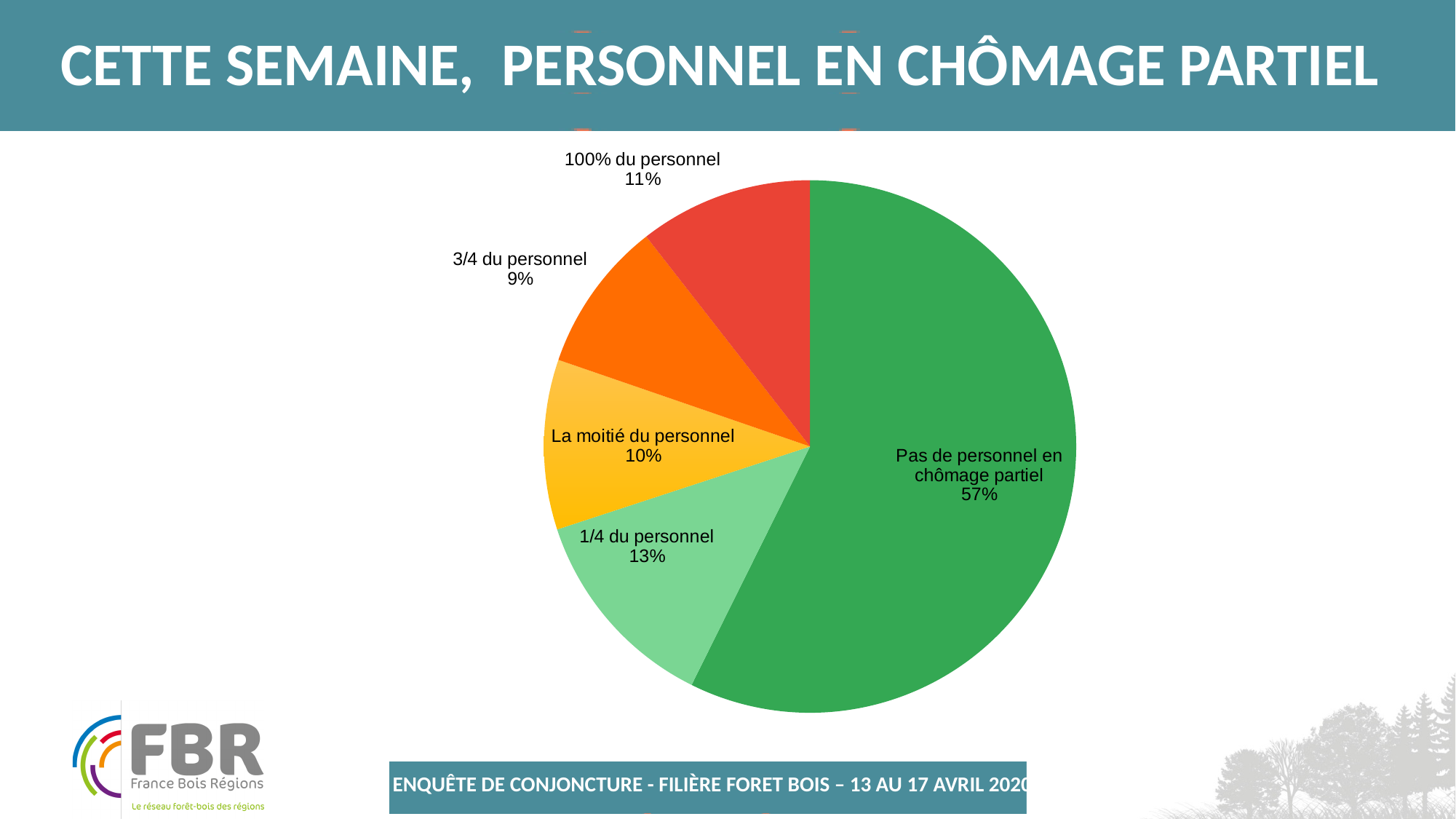
What is the value for '100% du personnel'? 11% Which is larger, '100% du personnel' or '3/4 du personnel'? 100% du personnel How many slices does the pie chart have? 5 What is the difference between 'Pas de personnel en chômage partiel' and '1/4 du personnel'? 44% Which category has the smallest slice? 3/4 du personnel What share of the pie is 'Pas de personnel en chômage partiel'? 57% What colour is the slice for 'Pas de personnel en chômage partiel'? green What is the value for '1/4 du personnel'? 13% Which category has the largest slice? Pas de personnel en chômage partiel What is the value for '3/4 du personnel'? 9% What is the value for 'La moitié du personnel'? 10% What kind of chart is shown on the slide? pie chart